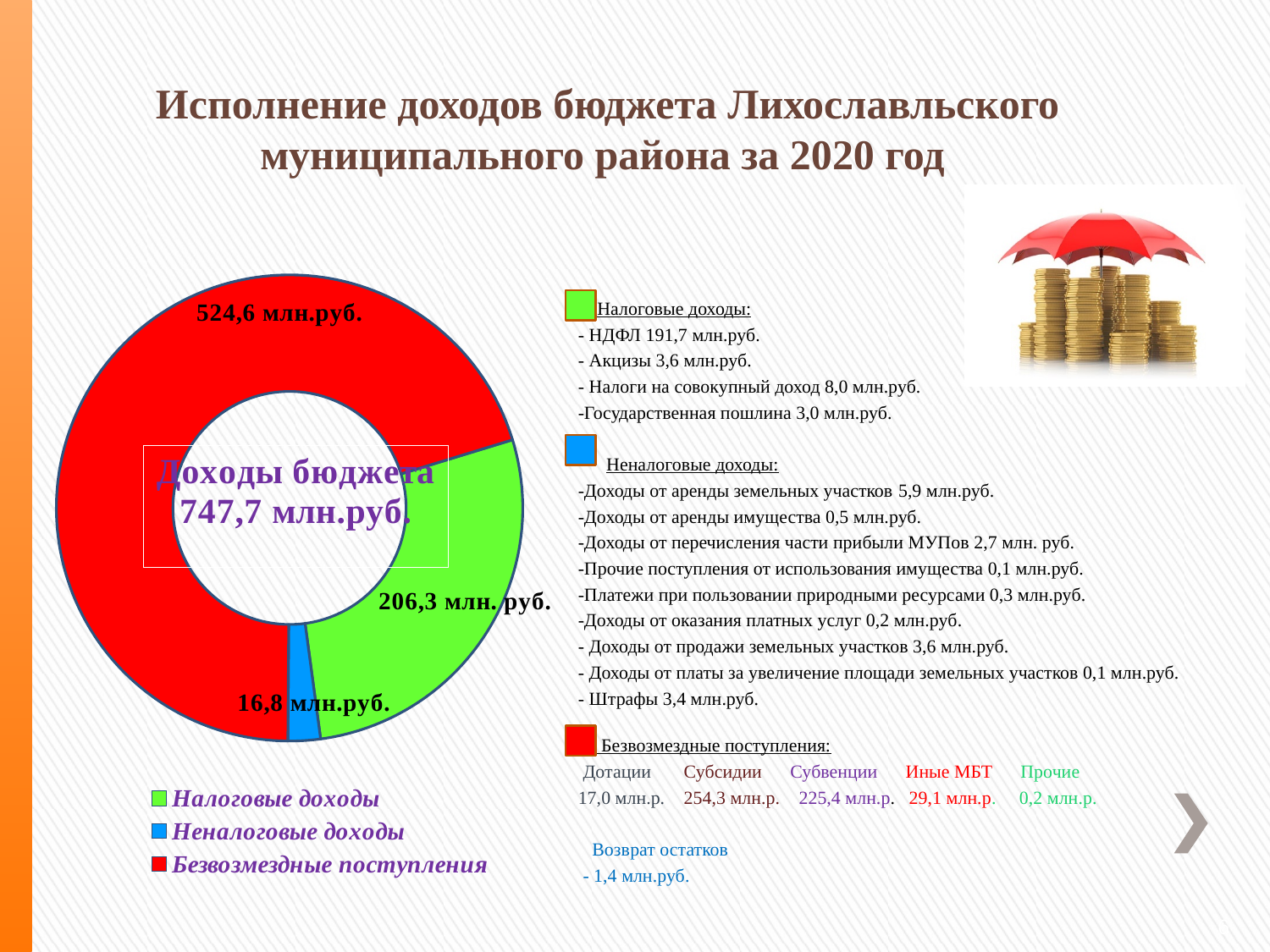
What colour represents Безвозмездные поступления in the chart? Red What is the value for Безвозмездные поступления in the chart? 524,6 млн.руб. What is the difference between Налоговые доходы and Неналоговые доходы? 189,5 млн.руб. What is the value for Неналоговые доходы in the chart? 16,8 млн.руб. Which category has the smallest slice in the chart? Неналоговые доходы What is the value for Налоговые доходы in the chart? 206,3 млн. руб. What total value is shown in the centre of the doughnut chart? 747,7 млн.руб. Which category has the largest slice in the chart? Безвозмездные поступления What type of chart is shown on the slide? Doughnut (pie) chart Which is larger: Налоговые доходы or Неналоговые доходы? Налоговые доходы What is the difference between Безвозмездные поступления and Налоговые доходы? 318,3 млн.руб. How many categories does the chart show? 3